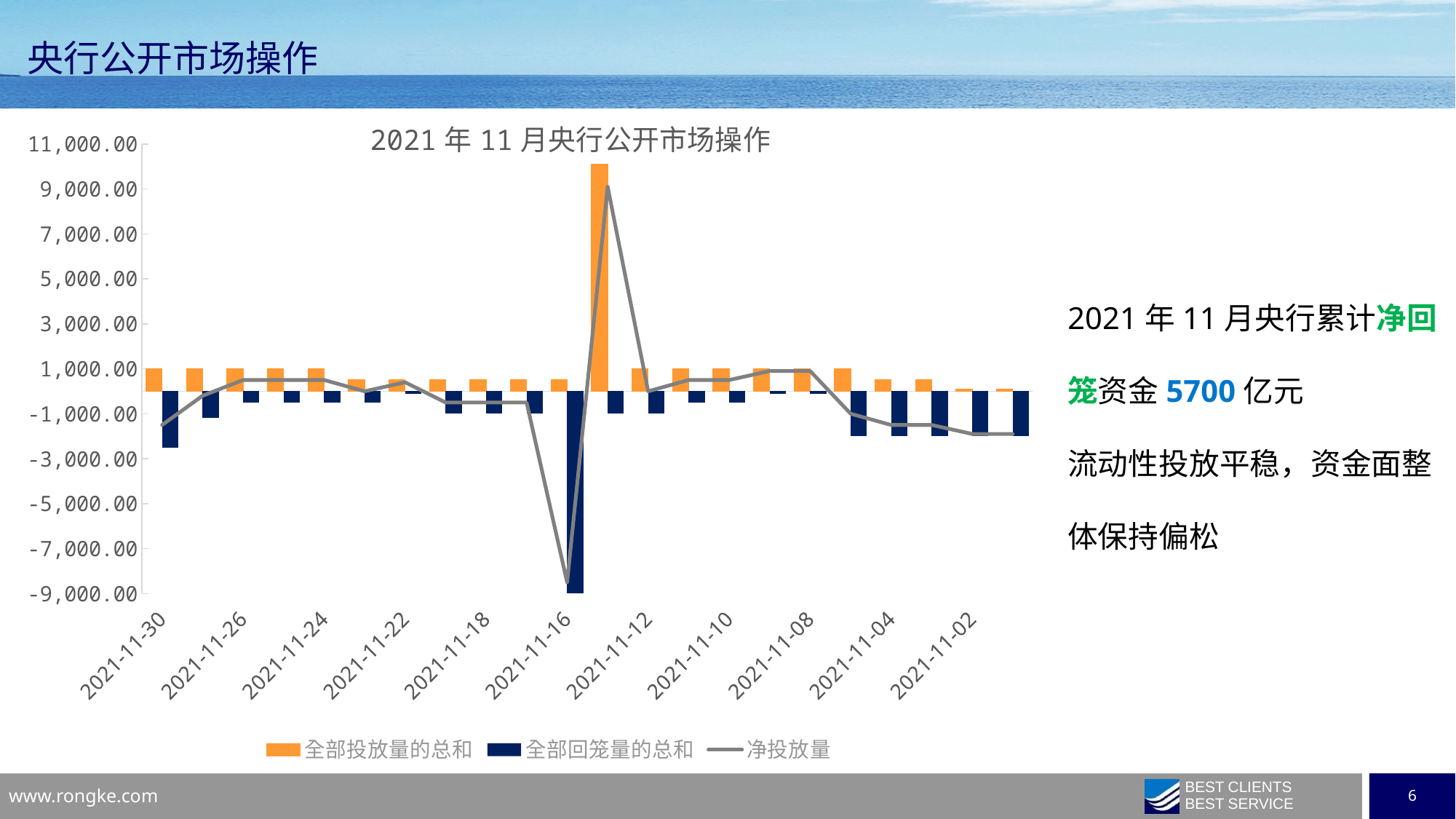
Is the 全部投放量的总和 value for 2021-11-02 greater or less than 1,000.00? less Is the 全部回笼量的总和 value for 2021-11-30 greater or less than -1,000.00? less Which series has the single tallest bar on the chart, 全部投放量的总和 or 全部回笼量的总和? 全部投放量的总和 Is the lowest point of the 净投放量 line greater or less than -7,000.00? less How many series does the chart legend list? 3 Which series is drawn as a line rather than bars? 净投放量 What kind of chart is shown on the slide? Combined bar and line chart What is the title of the chart? 2021 年 11 月央行公开市场操作